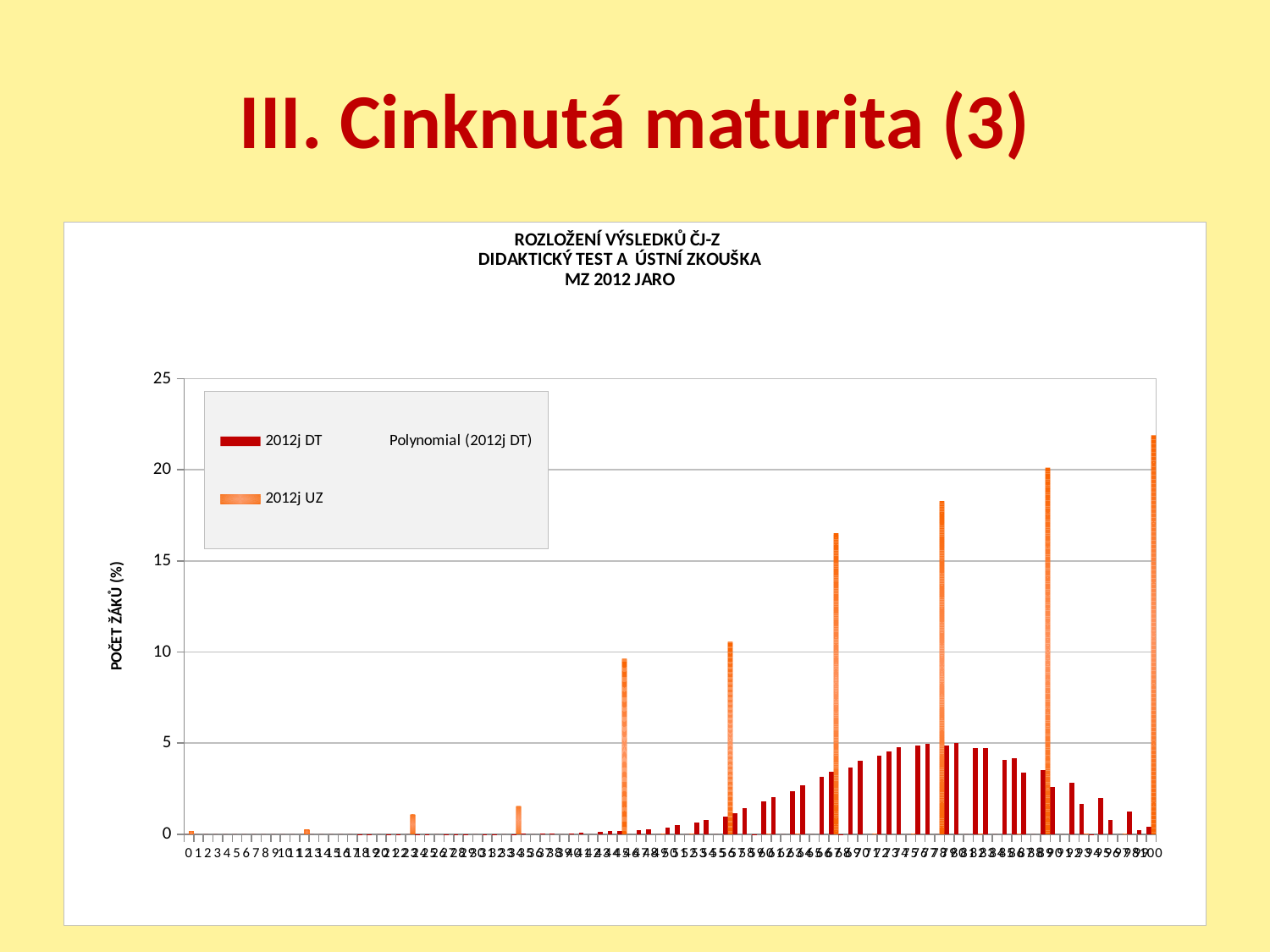
How many entries does the chart legend list? 3 What colour are the bars of the 2012j UZ series? orange Which is larger: the tallest 2012j DT bar or the tallest 2012j UZ bar? the tallest 2012j UZ bar Is the value of the 2012j UZ bar at 100 greater or less than 15? greater What kind of chart is shown on the slide? bar chart Which series has the tallest bar on the chart, 2012j DT or 2012j UZ? 2012j UZ Is the tallest 2012j DT bar greater or less than 10? less Do the 2012j DT values generally rise or fall along the x axis between 40 and 75? rise Is the tallest 2012j UZ bar greater or less than 20? greater What is the highest value shown on the vertical axis of the chart? 25 What is the label of the vertical axis of the chart? POČET ŽÁKŮ (%)